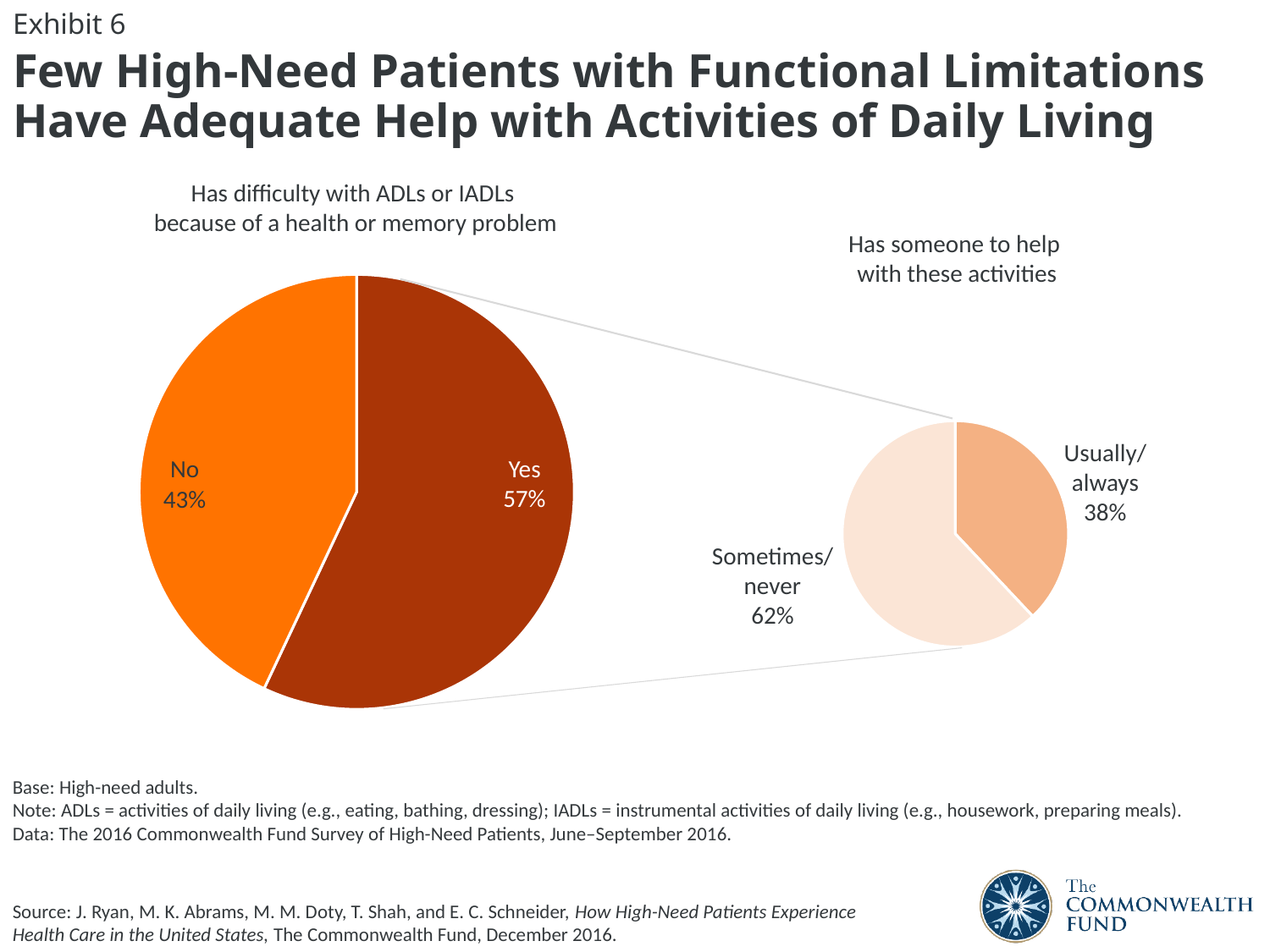
In the pie chart titled 'Has someone to help with these activities', what share answered Usually/always? 38% In the pie chart titled 'Has someone to help with these activities', what is the difference in percentage points between Sometimes/never and Usually/always? 24 percentage points In the pie chart titled 'Has someone to help with these activities', what share answered Sometimes/never? 62% How many pie charts are shown on the slide? 2 In the pie chart titled 'Has difficulty with ADLs or IADLs because of a health or memory problem', which slice is larger, Yes or No? Yes In the pie chart titled 'Has someone to help with these activities', which slice is the smallest? Usually/always In the pie chart titled 'Has difficulty with ADLs or IADLs because of a health or memory problem', what share of high-need adults answered Yes? 57% In the pie chart titled 'Has someone to help with these activities', which slice is the largest? Sometimes/never In the pie chart titled 'Has difficulty with ADLs or IADLs because of a health or memory problem', what share answered No? 43% What type of chart is used on this slide to show whether high-need adults have difficulty with ADLs or IADLs? Pie chart In the pie chart titled 'Has difficulty with ADLs or IADLs because of a health or memory problem', what is the difference in percentage points between the Yes and No slices? 14 percentage points How many slices does the pie chart titled 'Has difficulty with ADLs or IADLs because of a health or memory problem' have? 2